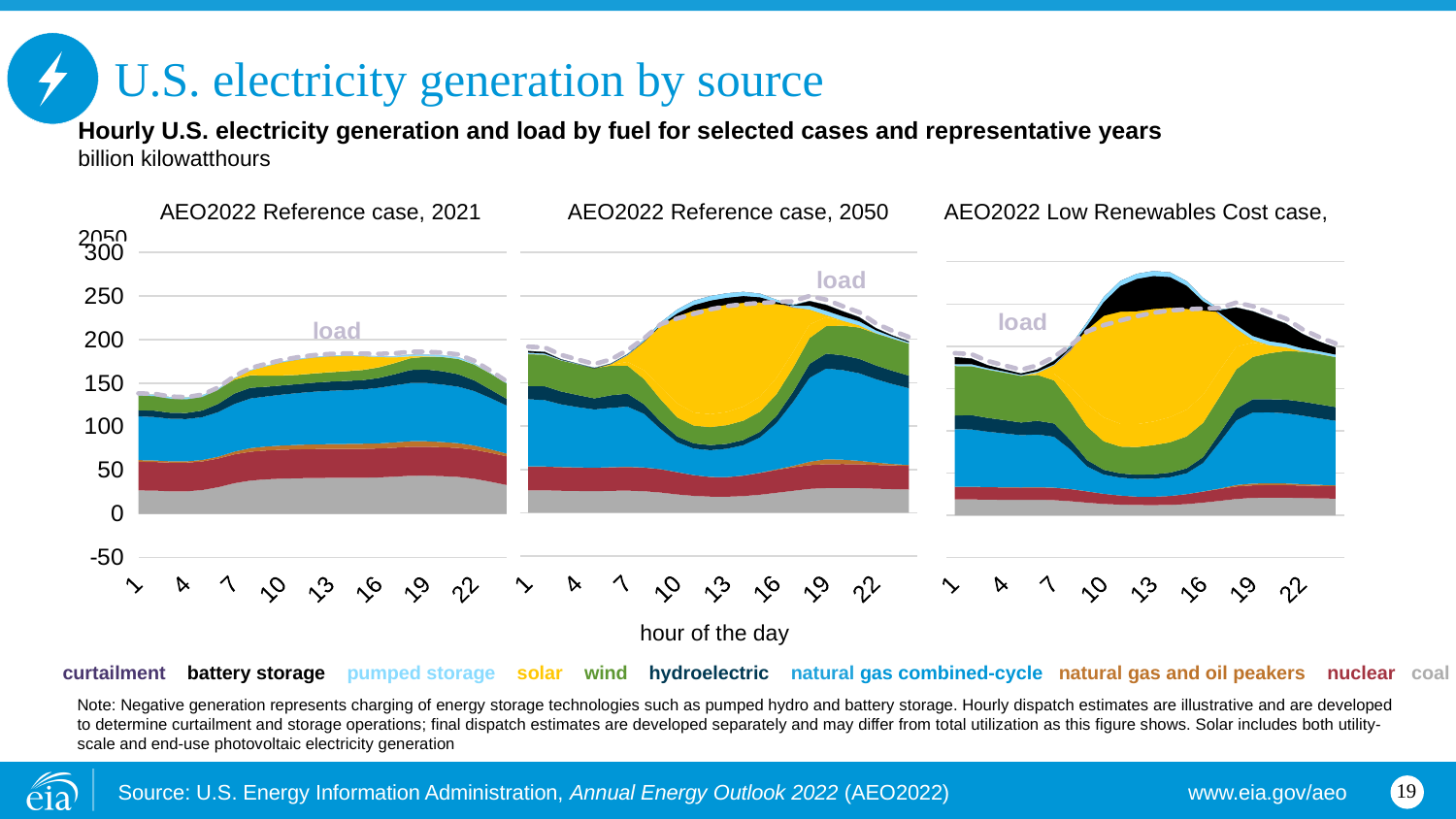
In the AEO2022 Reference case, 2050 chart, is the load at hour 4 greater or less than 200? less Which chart shows the higher peak load: AEO2022 Reference case, 2021 or AEO2022 Reference case, 2050? AEO2022 Reference case, 2050 What kind of chart is used in each of the three panels on this slide? stacked area chart How many charts (panels) are shown on the slide? 3 In what unit are the values on the y axis expressed? billion kilowatthours In the AEO2022 Low Renewables Cost case, 2050 chart, is the total generation at hour 13 greater or less than 250? greater In the AEO2022 Low Renewables Cost case, 2050 chart, is the load at hour 1 greater or less than 200? less In the AEO2022 Reference case, 2021 chart, does the load rise or fall from hour 1 to hour 13? rise What is the label of the x axis shared by the three charts? hour of the day How many fuel/technology series does the legend list? 10